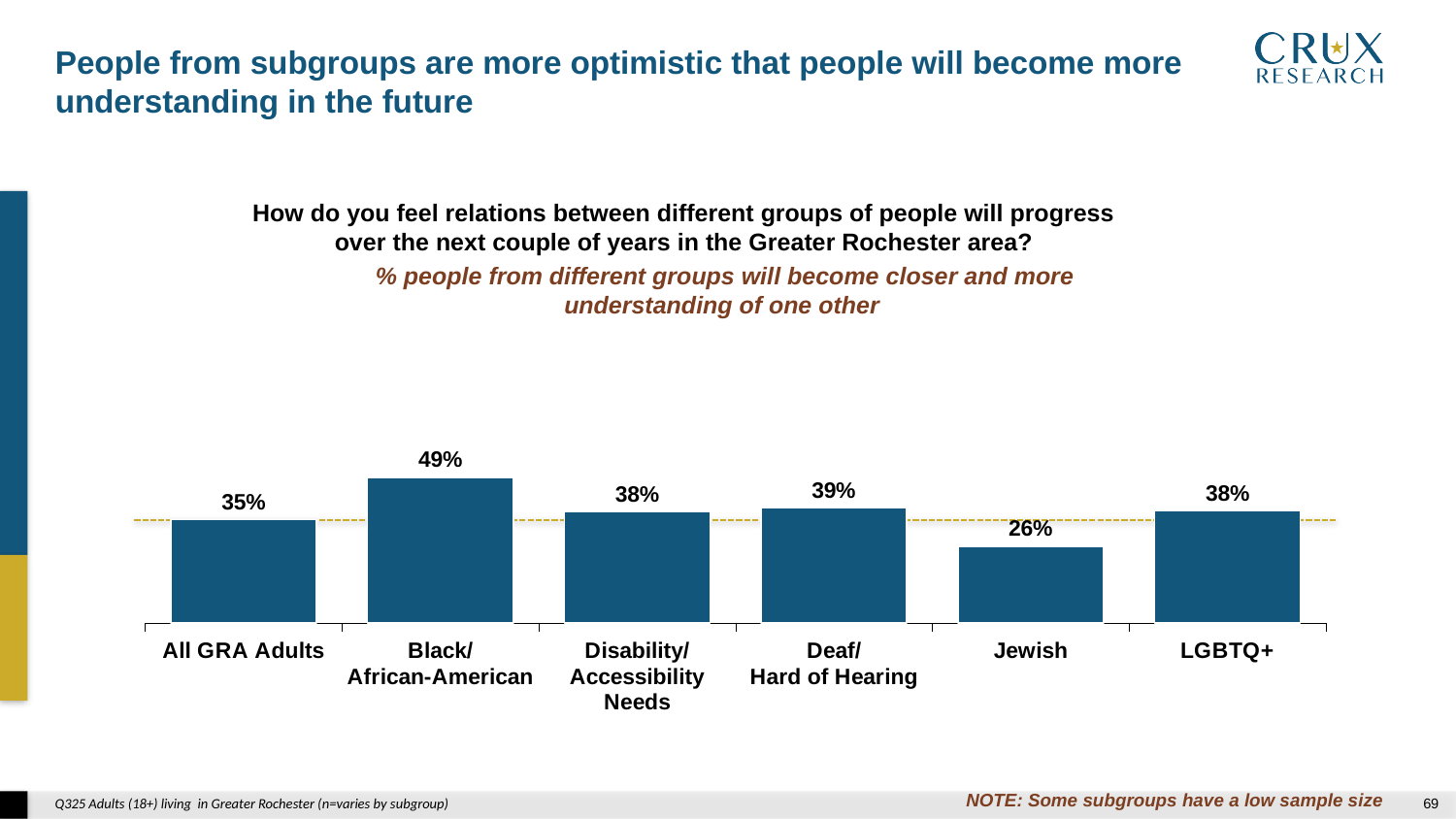
Which is larger, the value for LGBTQ+ or the value for Jewish? LGBTQ+ What kind of chart is shown on the slide? Bar chart What is the value shown for the Black/African-American subgroup? 49% What is the value shown for the Deaf/Hard of Hearing subgroup? 39% Which subgroup has the lowest percentage on the chart? Jewish What percentage of All GRA Adults say people from different groups will become closer and more understanding? 35% What is the value shown for the Jewish subgroup? 26% How many subgroups (bars) are shown on the chart? 6 What is the difference between the Deaf/Hard of Hearing value and the Jewish value? 13% Which two subgroups share the same value of 38%? Disability/Accessibility Needs and LGBTQ+ Which subgroup has the highest percentage on the chart? Black/African-American What is the difference between the Black/African-American value and the All GRA Adults value? 14%